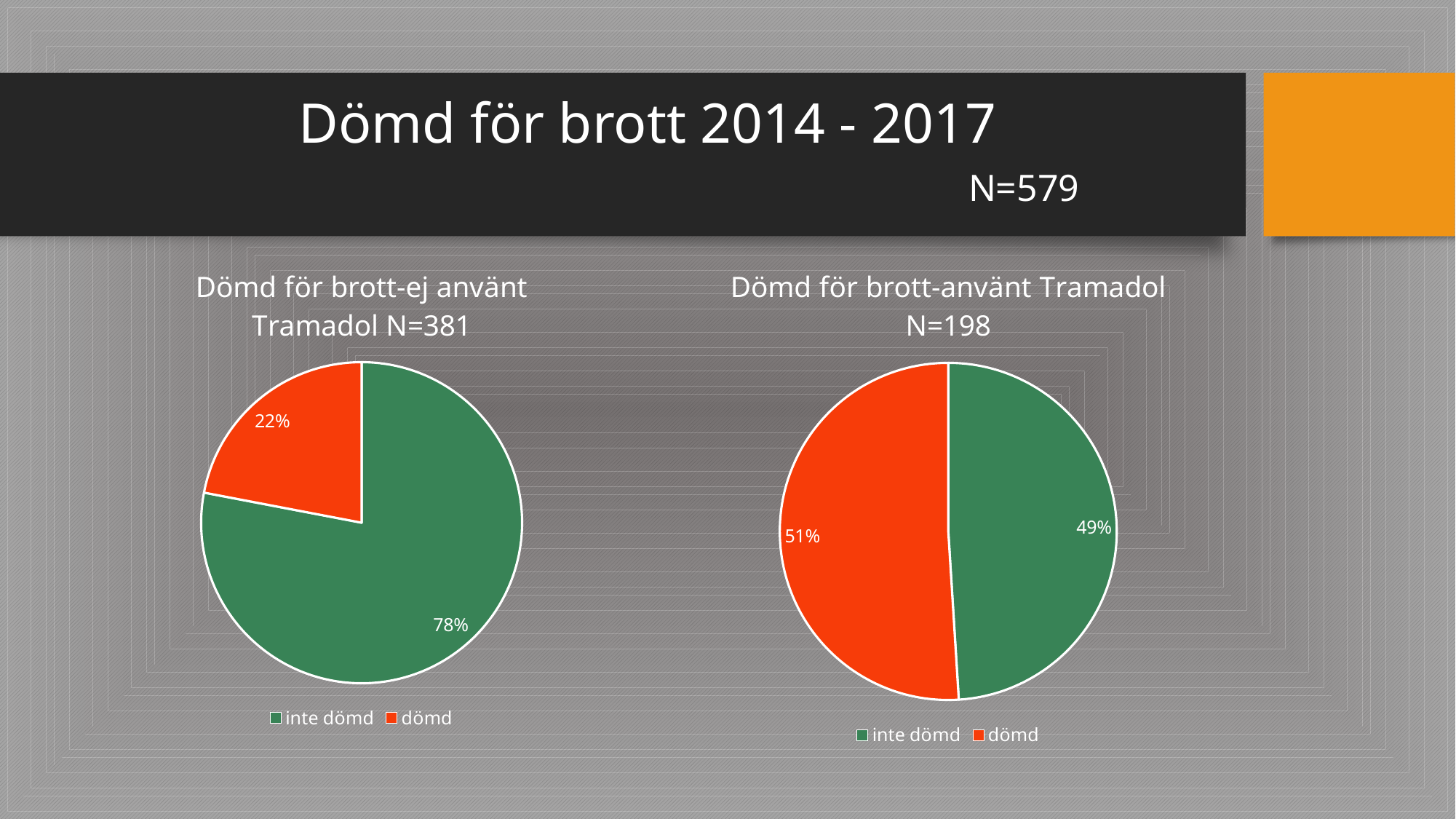
In the right chart 'Dömd för brott-använt Tramadol N=198', what share is 'inte dömd'? 49% In the right chart 'Dömd för brott-använt Tramadol N=198', what share is 'dömd'? 51% How many slices does the right chart 'Dömd för brott-använt Tramadol N=198' have? 2 In the left chart 'Dömd för brott-ej använt Tramadol N=381', what share is 'dömd'? 22% In the left chart 'Dömd för brott-ej använt Tramadol N=381', what share is 'inte dömd'? 78% Which is larger: the 'dömd' share in the left chart or the 'dömd' share in the right chart? the right chart (51%) In the left chart 'Dömd för brott-ej använt Tramadol N=381', which slice is the smallest? dömd In the left chart 'Dömd för brott-ej använt Tramadol N=381', what is the difference between the 'inte dömd' and 'dömd' shares? 56% In the left chart 'Dömd för brott-ej använt Tramadol N=381', which slice is the largest? inte dömd What kind of chart is the left chart 'Dömd för brott-ej använt Tramadol N=381'? pie chart In the right chart 'Dömd för brott-använt Tramadol N=198', what colour is the 'dömd' slice? red In the right chart 'Dömd för brott-använt Tramadol N=198', what is the difference between the 'dömd' and 'inte dömd' shares? 2%